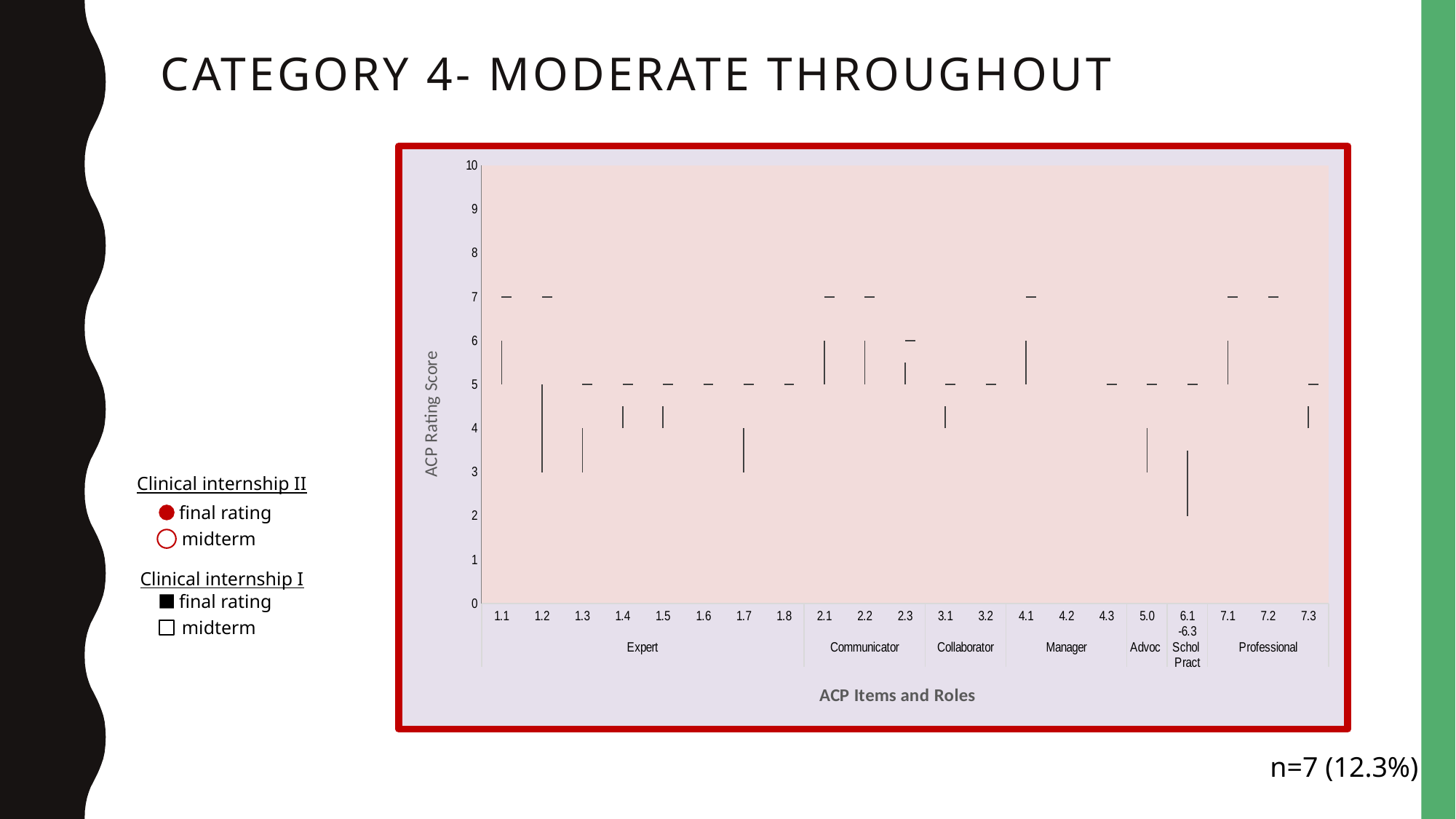
Is the lowest value for item 1.7 greater or less than 4? less Which ACP item has the lowest plotted value on the chart? 6.1-6.3 How many ACP item categories are labelled along the x axis of the chart? 21 What is the maximum value shown on the y axis of the chart? 10 Is the lowest value for item 1.2 greater or less than 4? less What is the lowest value reached by the line for item 6.1-6.3? 2 What is the title of the y axis on the chart? ACP Rating Score Is the highest value of the vertical line for item 1.1 greater or less than 5? greater How many role groups are labelled along the x axis of the chart? 7 Which role group contains the most ACP items on the x axis? Expert What is the title of the x axis on the chart? ACP Items and Roles